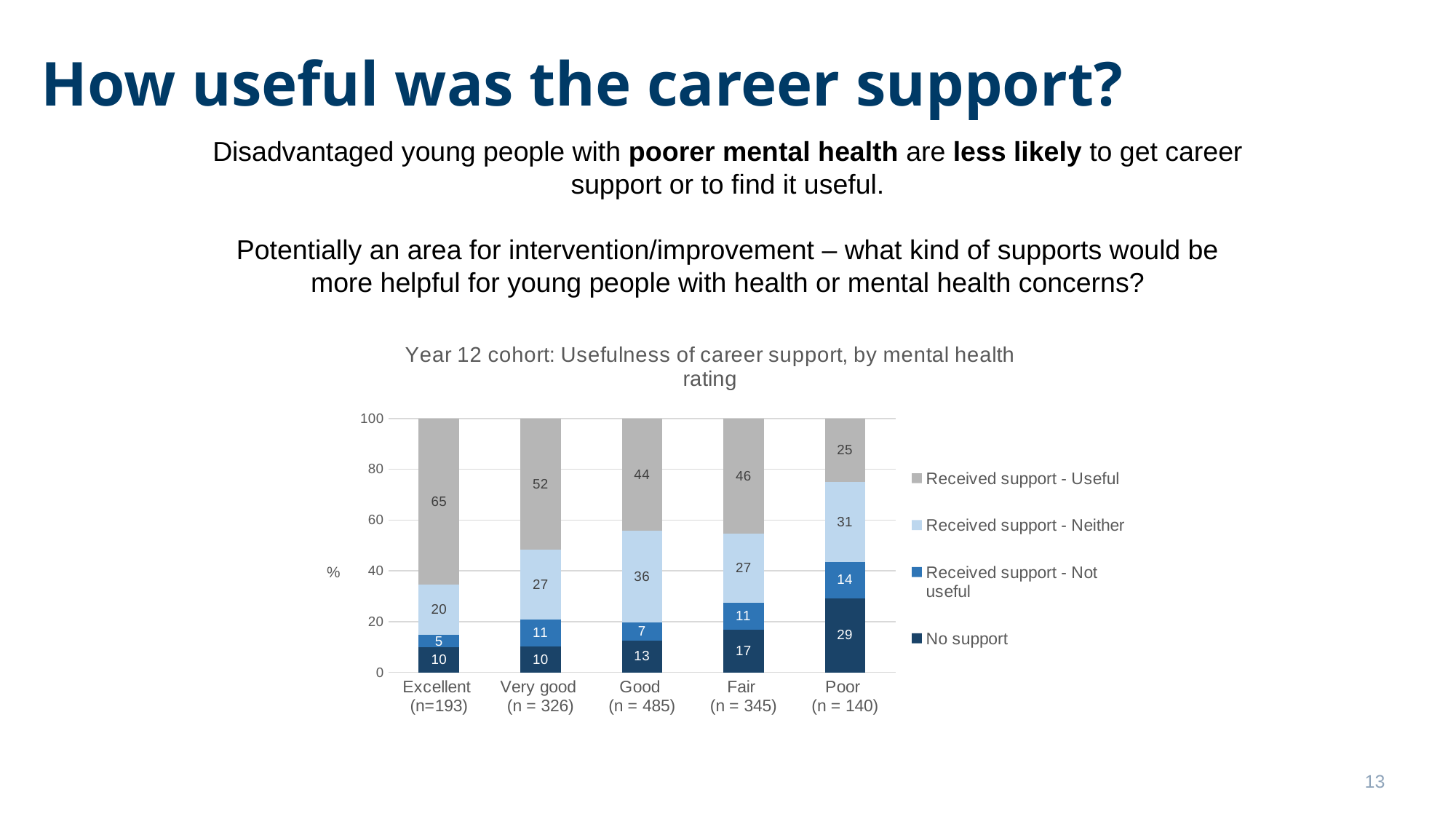
Which category has the highest value for 'Received support - Useful'? Excellent Is the 'No support' value larger for Fair or for Good? Fair Which category has the lowest value for 'No support'? Excellent and Very good (both 10) What kind of chart is shown on the slide? Stacked bar chart Does the 'No support' value rise or fall moving from Excellent to Poor along the x axis? Rise What is the value for 'Received support - Neither' in the Good category? 36 How many series does the legend list? 4 What is the value for 'Received support - Not useful' in the Fair category? 11 What is the difference between the 'Received support - Useful' values for Excellent and Poor? 40 What is the value for 'Received support - Useful' in the Excellent category? 65 How many mental health rating categories are shown on the x axis? 5 What is the value for 'No support' in the Poor category? 29